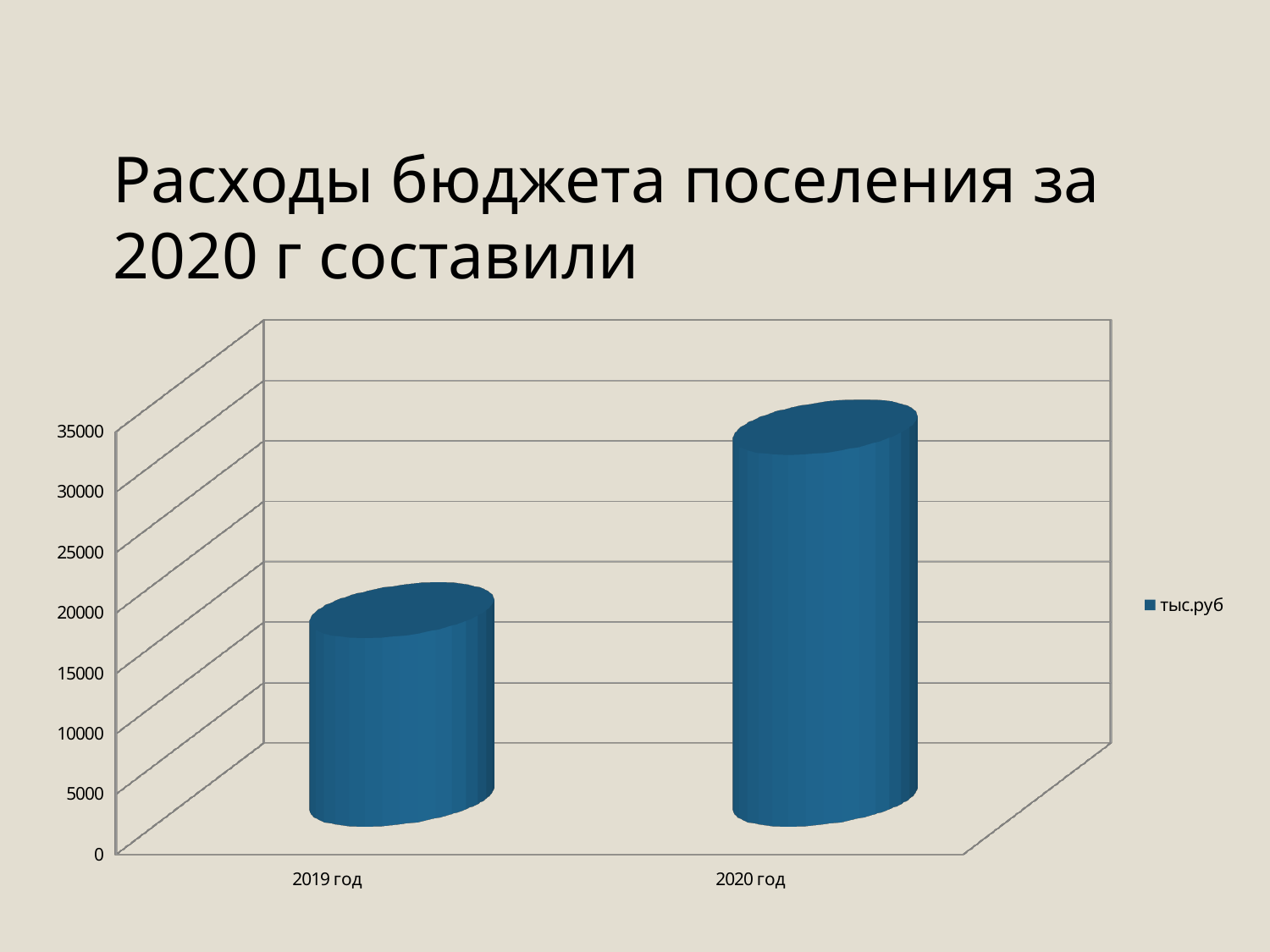
How many categories are shown on the x axis of the chart? 2 Which year has the lower value in the chart? 2019 год Do the values rise or fall from 2019 год to 2020 год? rise Is the value for 2020 год greater or less than 25000? greater Is the value for 2019 год greater or less than 30000? less What is the title of the slide containing the chart? Расходы бюджета поселения за 2020 г составили Is the value for 2020 год larger or smaller than the value for 2019 год? larger Which year has the higher value in the chart? 2020 год What kind of chart is shown on the slide? bar chart Is the value for 2019 год greater or less than 10000? greater What is the name of the series shown in the chart legend? тыс.руб How many series does the chart legend list? 1